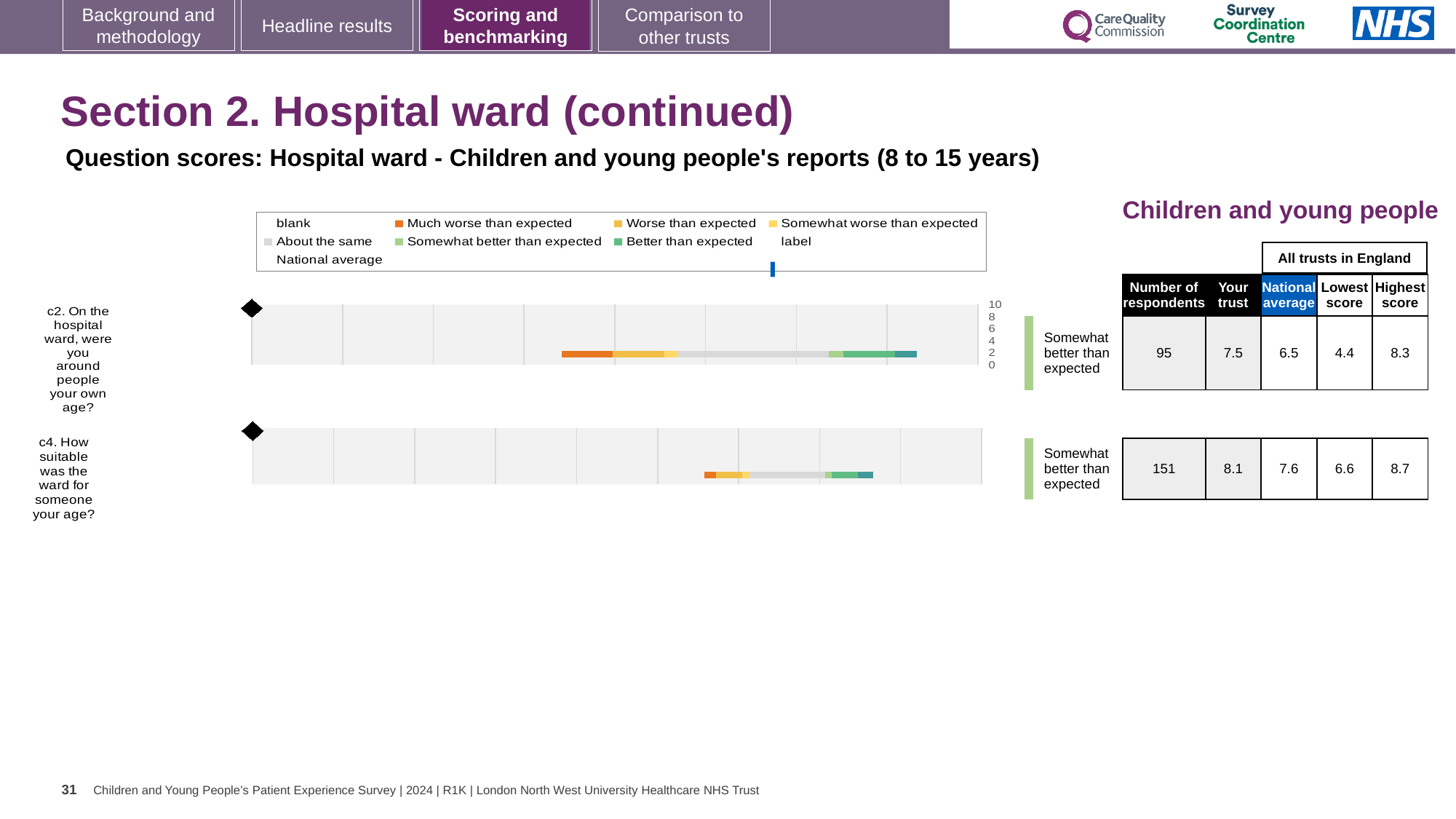
What is the difference between the 'Your trust' score and the national average for question c2? 1.0 For question c4 (How suitable was the ward for someone your age?), what is the 'Your trust' score? 8.1 What is the national average score for question c2? 6.5 For question c2 (On the hospital ward, were you around people your own age?), what is the 'Your trust' score? 7.5 What kind of chart is used to show the question scores for c2 and c4? bar chart What is the highest score across all trusts in England for question c4? 8.7 What is the number of respondents for question c4? 151 What is the difference between the highest and lowest scores across all trusts in England for question c4? 2.1 What benchmark rating label is shown next to the chart for question c2? Somewhat better than expected What is the lowest score across all trusts in England for question c2? 4.4 How many questions (categories) are plotted on the slide? 2 Which question has the higher 'Your trust' score, c2 or c4? c4